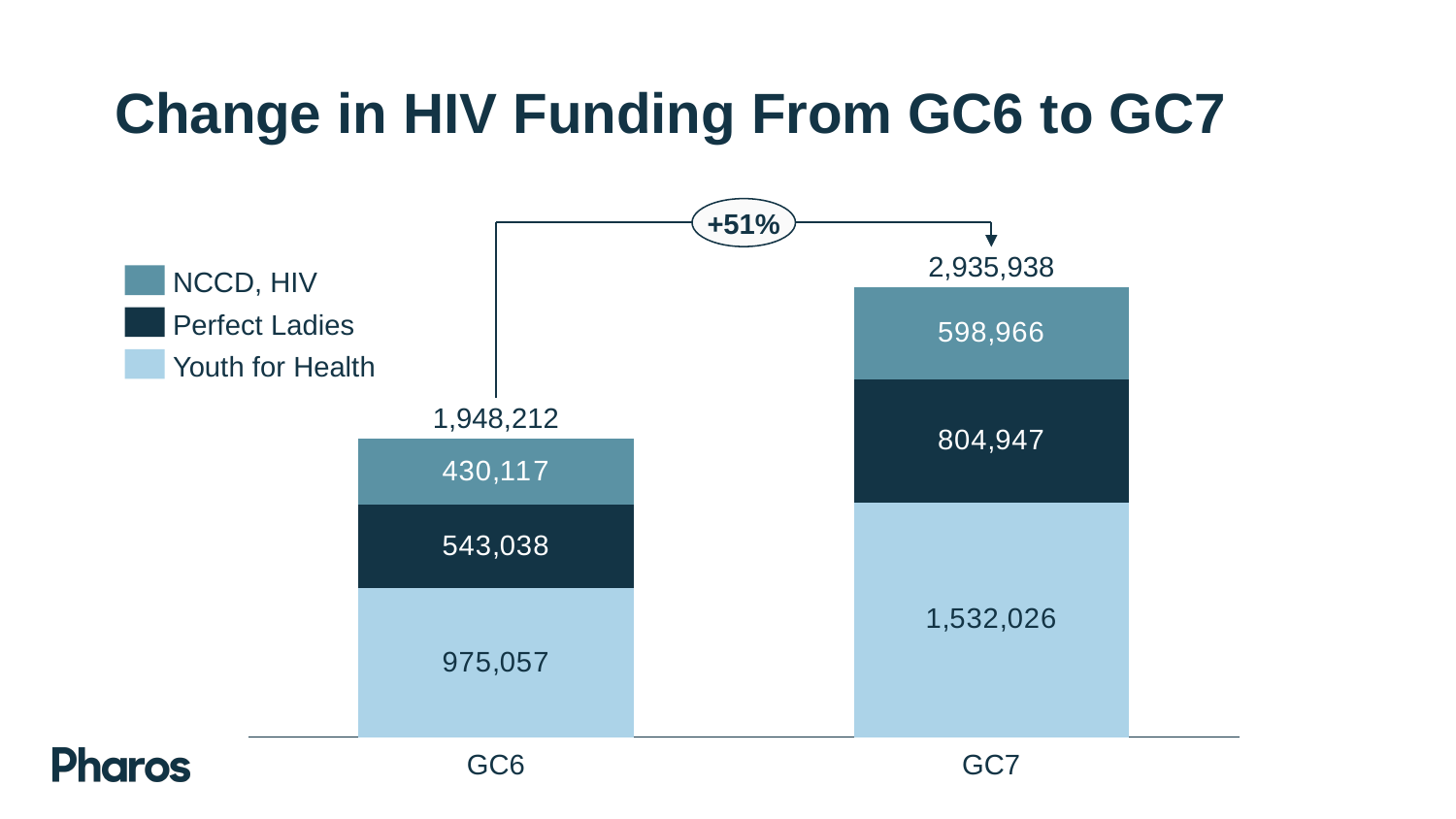
Is the NCCD, HIV value larger for GC6 or GC7? GC7 Which series has the smallest value in the GC6 bar? NCCD, HIV How many series does the legend list? 3 What is the total funding shown for the GC7 bar? 2,935,938 What is the total funding shown for the GC6 bar? 1,948,212 What is the Perfect Ladies value for GC7? 804,947 What percentage change in total funding from GC6 to GC7 is annotated on the chart? +51% What is the NCCD, HIV value for GC7? 598,966 What is the difference between the Perfect Ladies values for GC7 and GC6? 261,909 What is the Youth for Health value for GC6? 975,057 What is the difference between the Youth for Health values for GC7 and GC6? 556,969 Which series has the largest value in the GC7 bar? Youth for Health